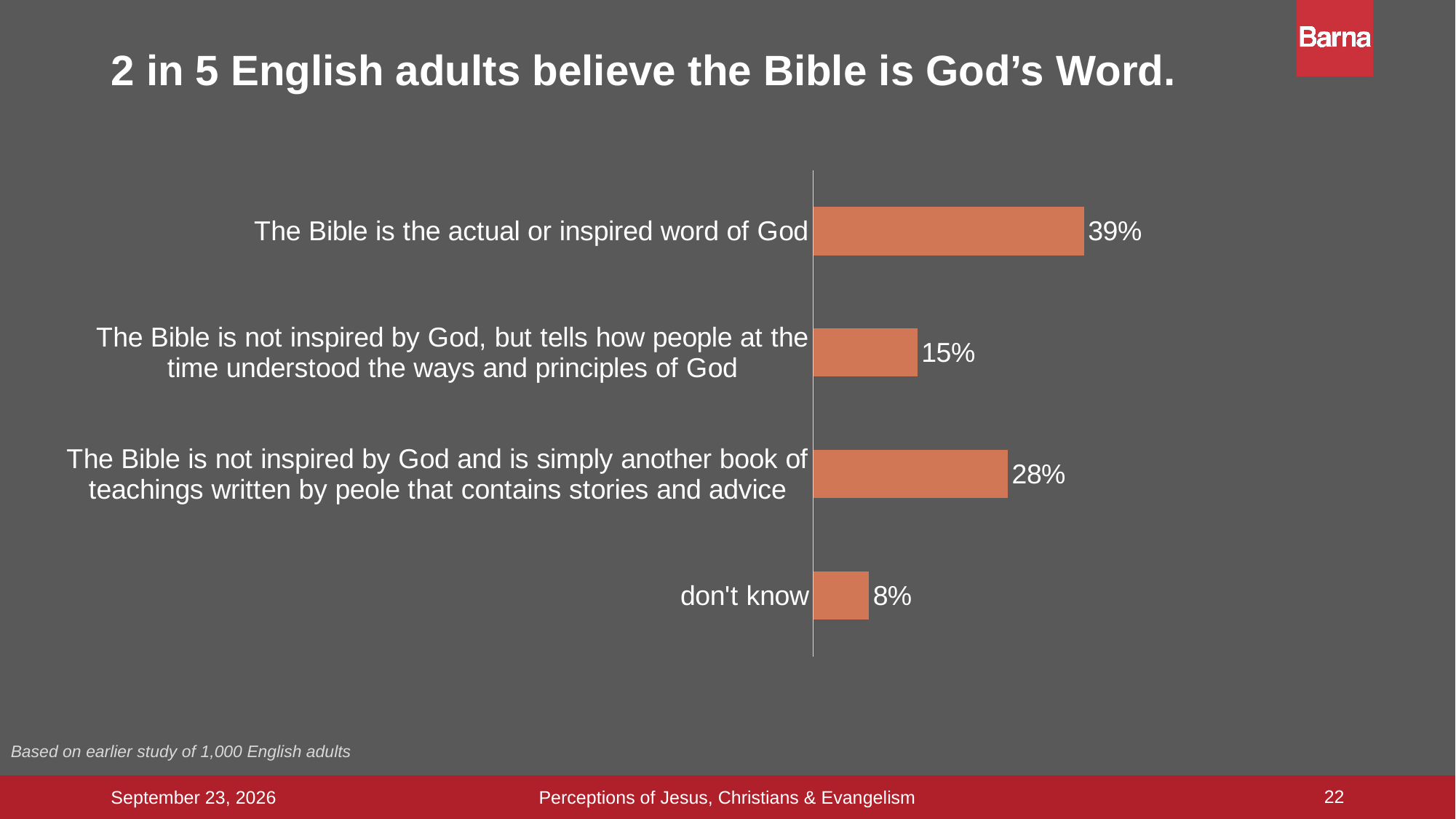
What is the difference in percentage points between the "simply another book of teachings" response and the "tells how people at the time understood the ways and principles of God" response? 13 How many response categories are shown in the chart? 4 What percentage say the Bible is not inspired by God and is simply another book of teachings written by people? 28% What percentage of respondents answered "don't know"? 8% What type of chart is shown on the slide? bar chart What is the difference in percentage points between "The Bible is the actual or inspired word of God" and "don't know"? 31 Which response has the lowest percentage? don't know Which response has the highest percentage? The Bible is the actual or inspired word of God What is the title of the slide? 2 in 5 English adults believe the Bible is God's Word. Which is larger: the percentage for "simply another book of teachings" or the percentage for "not inspired by God, but tells how people at the time understood the ways and principles of God"? simply another book of teachings What percentage say the Bible is not inspired by God, but tells how people at the time understood the ways and principles of God? 15% What percentage of English adults say the Bible is the actual or inspired word of God? 39%